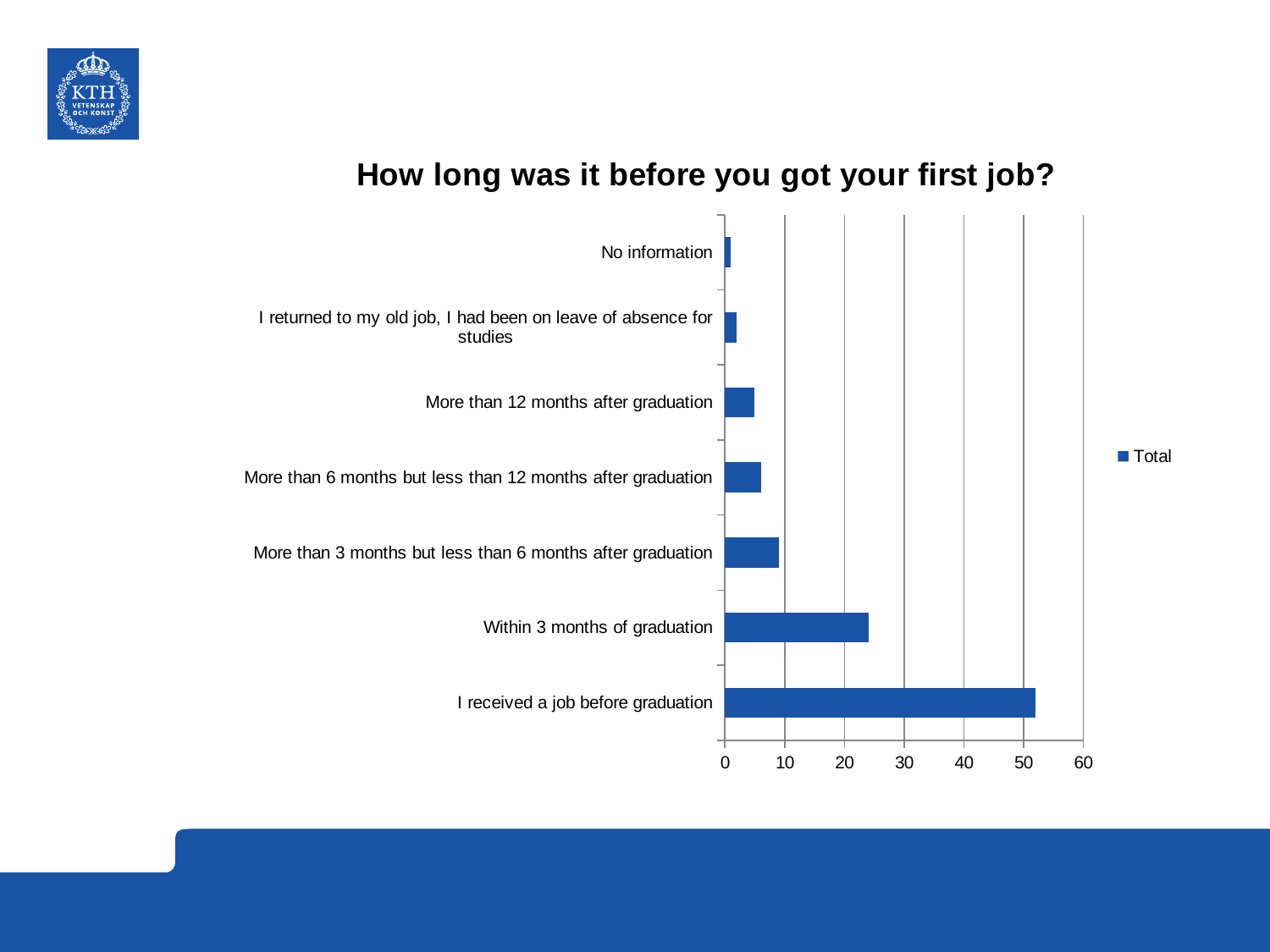
What series name is shown in the legend? Total How many series does the legend list? 1 Is the value for 'Within 3 months of graduation' greater or less than 30? less How many categories are shown in the chart? 7 Which is larger: the value for 'Within 3 months of graduation' or the value for 'More than 12 months after graduation'? Within 3 months of graduation What is the title of the chart? How long was it before you got your first job? What kind of chart is shown on the slide? bar chart Is the value for 'Within 3 months of graduation' greater or less than 20? greater Which is larger: the value for 'More than 3 months but less than 6 months after graduation' or the value for 'No information'? More than 3 months but less than 6 months after graduation Is the value for 'I received a job before graduation' greater or less than 50? greater Which category has the highest value? I received a job before graduation